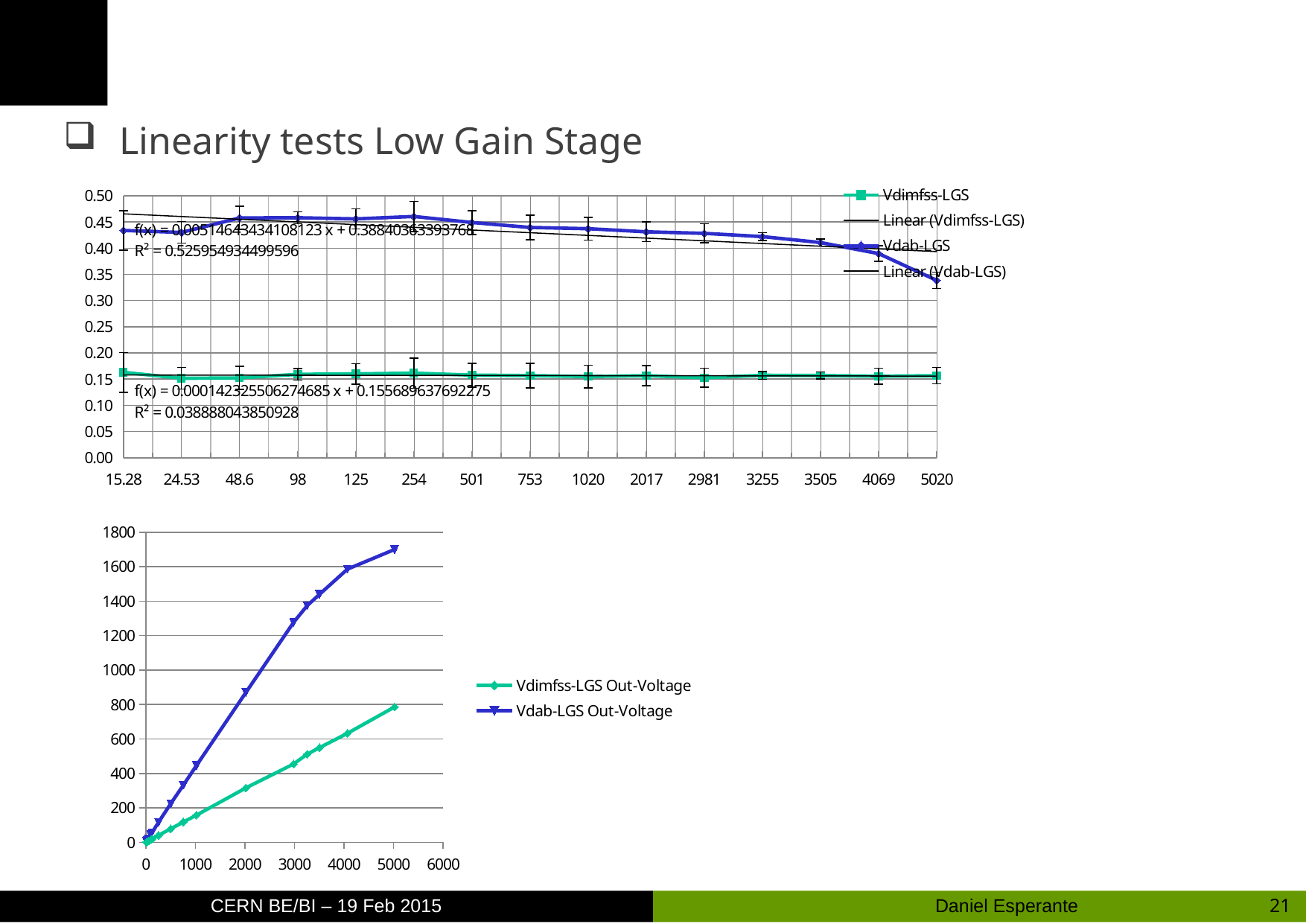
What kind of chart is the top chart? line chart On the top chart, which series has the larger value at 254, Vdab-LGS or Vdimfss-LGS? Vdab-LGS On the top chart, is the value of Vdab-LGS at 5020 greater or less than 0.40? less On the top chart, how many series does the legend list? 4 On the bottom chart, does the Vdab-LGS Out-Voltage series rise or fall as x increases? rise On the bottom chart, how many series does the legend list? 2 On the top chart, how many categories are shown on the x axis? 15 On the bottom chart, is the value of Vdab-LGS Out-Voltage at x = 5000 greater or less than 1600? greater On the top chart, does the Vdab-LGS series rise or fall between 3505 and 5020? fall On the top chart, what R² value is shown for the Vdab-LGS linear fit? 0.525954934499596 On the top chart, is the value of Vdimfss-LGS at 15.28 greater or less than 0.20? less On the bottom chart, which series has the larger value at x = 5000, Vdab-LGS Out-Voltage or Vdimfss-LGS Out-Voltage? Vdab-LGS Out-Voltage